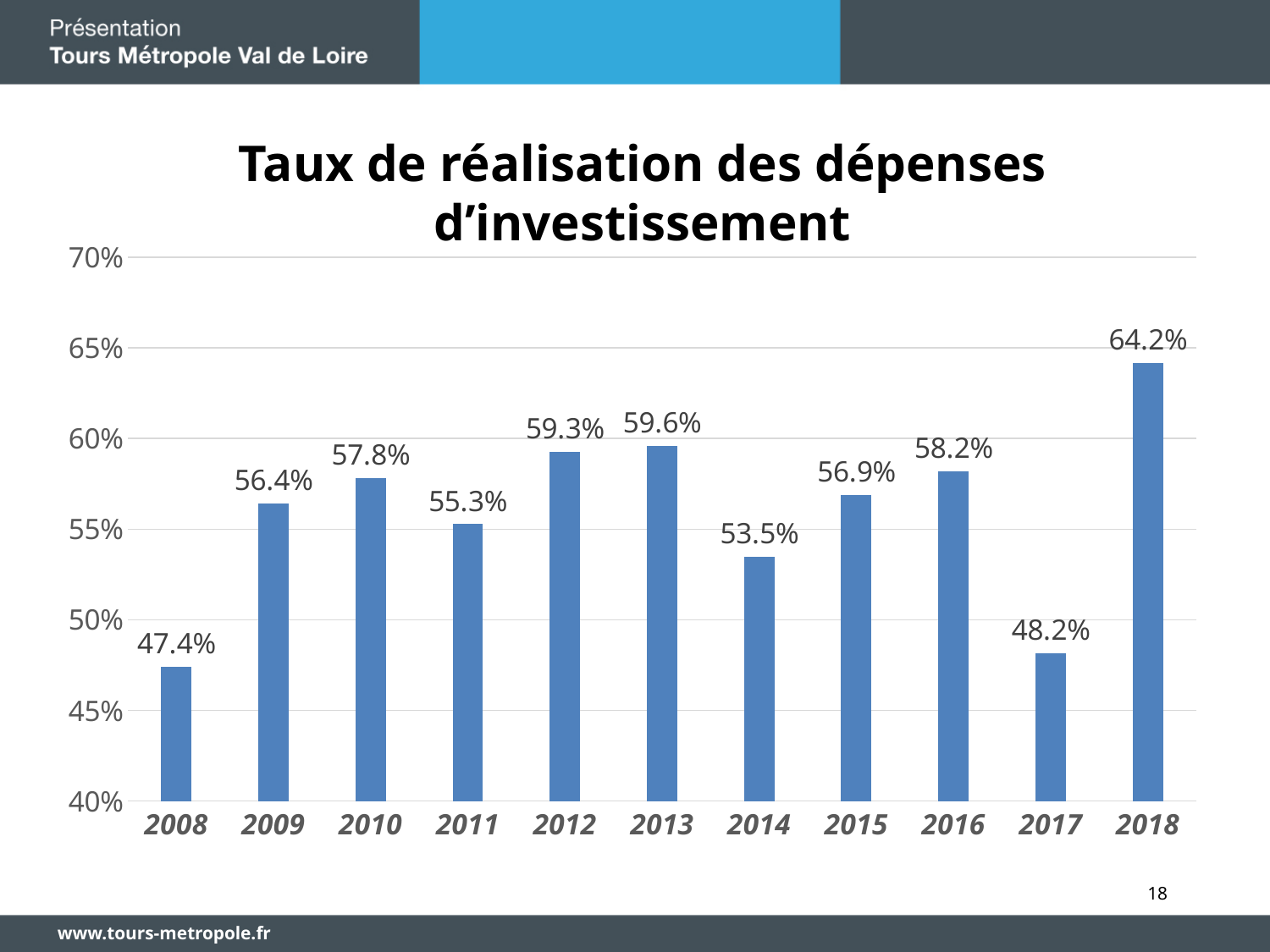
What is the value for 2017? 48.2% Which year has the lowest value? 2008 What is the difference between the values for 2018 and 2017? 16 percentage points Which year has the highest value? 2018 What is the value for 2008? 47.4% What is the title of the chart? Taux de réalisation des dépenses d'investissement What kind of chart is this? Bar chart What is the difference between the values for 2013 and 2014? 6.1 percentage points Which is larger, the value for 2010 or the value for 2011? 2010 Is the value for 2016 greater or less than 55%? greater What is the value for 2013? 59.6% How many years are shown on the x axis? 11